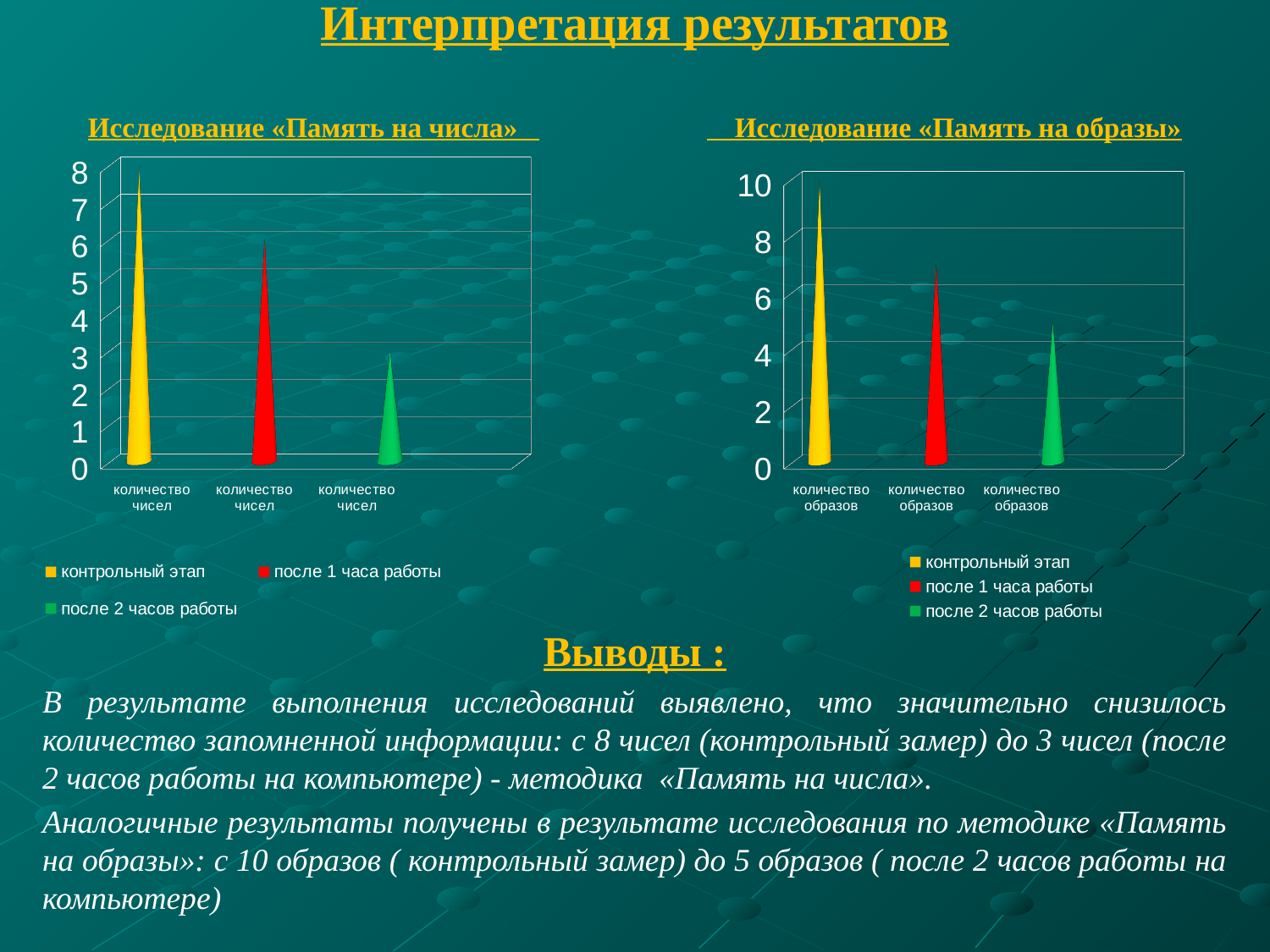
On the chart «Память на числа», what is the difference between контрольный этап and после 2 часов работы? 5 On the chart «Память на образы», what is the value for контрольный этап? 10 On the chart «Память на образы», is the value for после 2 часов работы greater or less than 6? less On the chart «Память на образы», do the values rise or fall from left to right? fall How many series does the legend of the chart «Память на числа» list? 3 On the chart «Память на образы», which series has the highest value? контрольный этап On the chart «Память на числа», what is the value for после 1 часа работы? 6 On the chart «Память на образы», is the value for после 1 часа работы greater or less than 6? greater On the chart «Память на числа», what is the value for контрольный этап? 8 On the chart «Память на числа», what is the value for после 2 часов работы? 3 On the chart «Память на образы», which is larger: после 1 часа работы or после 2 часов работы? после 1 часа работы On the chart «Память на числа», which series has the lowest value? после 2 часов работы